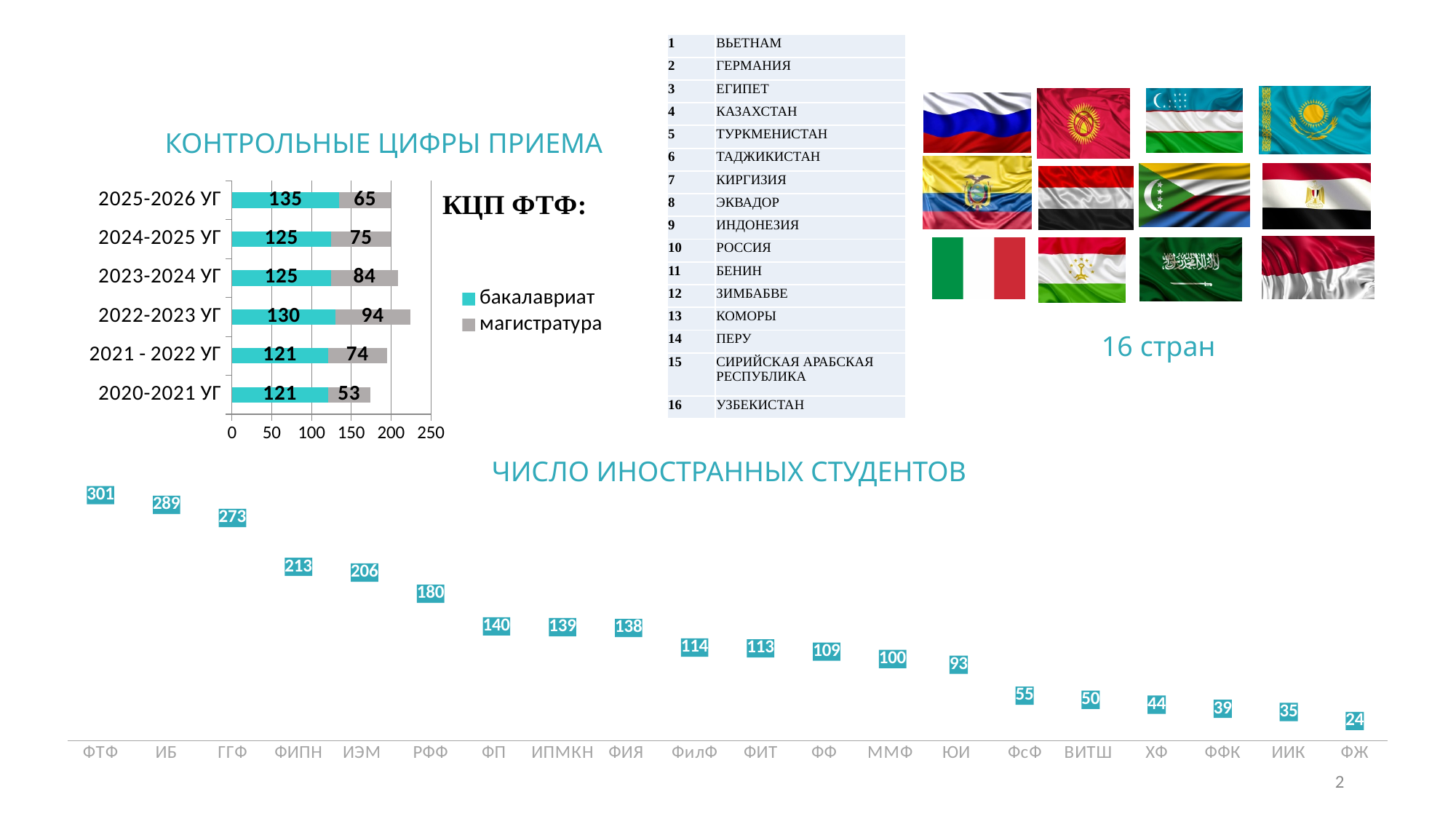
In the chart titled КОНТРОЛЬНЫЕ ЦИФРЫ ПРИЕМА, what is the бакалавриат value for 2025-2026 УГ? 135 In the chart titled КОНТРОЛЬНЫЕ ЦИФРЫ ПРИЕМА, what is the total of the stacked bar for 2023-2024 УГ? 209 In the chart titled ЧИСЛО ИНОСТРАННЫХ СТУДЕНТОВ, which category has the highest value? ФТФ In the chart titled КОНТРОЛЬНЫЕ ЦИФРЫ ПРИЕМА, what is the магистратура value for 2022-2023 УГ? 94 In the chart titled КОНТРОЛЬНЫЕ ЦИФРЫ ПРИЕМА, how many series does the legend list? 2 In the chart titled ЧИСЛО ИНОСТРАННЫХ СТУДЕНТОВ, do the values rise or fall from left to right along the x axis? Fall In the chart titled КОНТРОЛЬНЫЕ ЦИФРЫ ПРИЕМА, what is the difference between the магистратура values for 2024-2025 УГ and 2025-2026 УГ? 10 In the chart titled КОНТРОЛЬНЫЕ ЦИФРЫ ПРИЕМА, which year has the lowest магистратура value? 2020-2021 УГ In the chart titled ЧИСЛО ИНОСТРАННЫХ СТУДЕНТОВ, what is the value for ФИПН? 213 In the chart titled КОНТРОЛЬНЫЕ ЦИФРЫ ПРИЕМА, what kind of chart is shown? Stacked bar chart In the chart titled ЧИСЛО ИНОСТРАННЫХ СТУДЕНТОВ, how many categories are shown on the x axis? 20 In the chart titled ЧИСЛО ИНОСТРАННЫХ СТУДЕНТОВ, which category has the lowest value? ФЖ